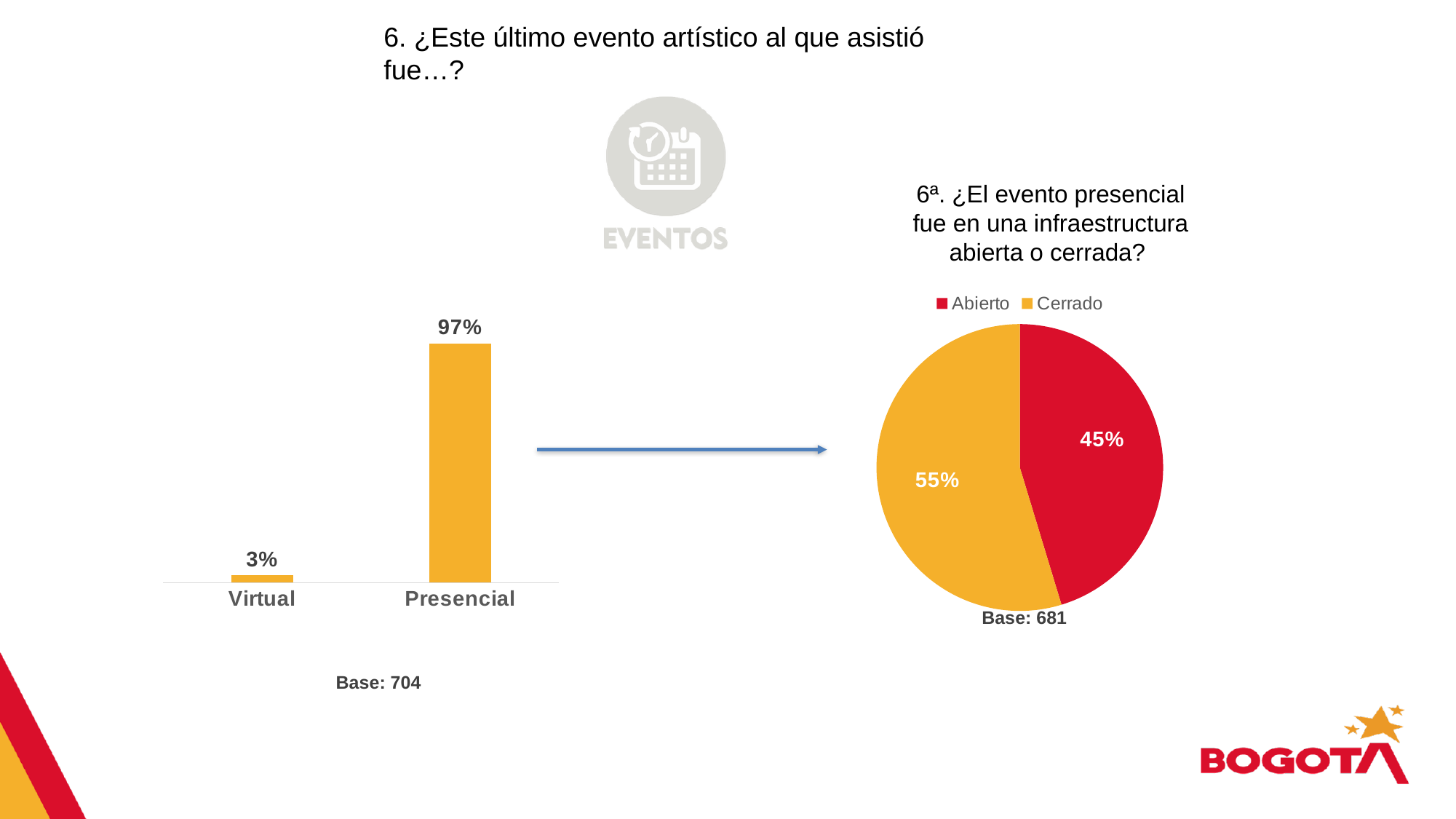
In the pie chart on the right, what share does Cerrado have? 55% In the pie chart on the right, what colour is the Abierto slice? Red In the bar chart on the left, what is the value for Presencial? 97% In the bar chart on the left, how many categories are shown? 2 What kind of chart is the chart on the left of the slide? Bar chart In the pie chart on the right, which is larger, Abierto or Cerrado? Cerrado In the bar chart on the left, which category has the highest value? Presencial How many entries does the legend of the pie chart on the right list? 2 In the bar chart on the left, what is the value for Virtual? 3% In the bar chart on the left, which category has the lowest value? Virtual In the bar chart on the left, what is the difference between the values for Presencial and Virtual? 94% In the pie chart on the right, what share does Abierto have? 45%